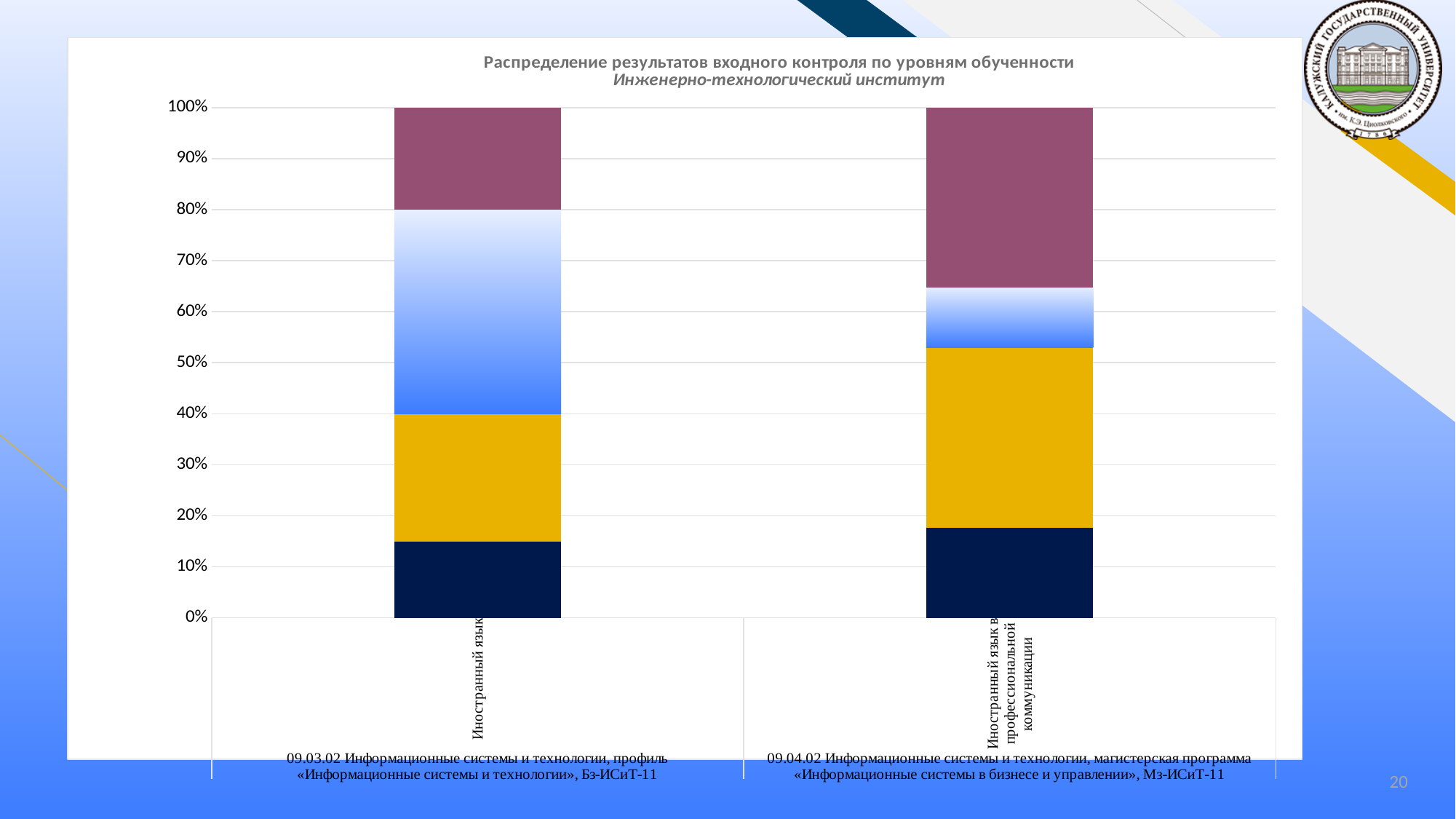
Which bar has the larger yellow segment: 09.03.02 (Бз-ИСиТ-11) or 09.04.02 (Мз-ИСиТ-11)? 09.04.02 (Мз-ИСиТ-11) What is the total height of each stacked bar on the percentage axis? 100% Is the top of the yellow segment in the bar for 09.03.02 (Бз-ИСиТ-11) greater or less than 50%? less Is the bottom of the purple (top) segment in the bar for 09.04.02 (Мз-ИСиТ-11) greater or less than 60%? greater Is the top of the blue segment in the bar for 09.03.02 (Бз-ИСиТ-11) greater or less than 70%? greater What kind of chart is shown on the slide? Stacked bar chart How many bars (categories) are plotted in the chart? 2 Which bar has the larger blue segment: 09.03.02 (Бз-ИСиТ-11) or 09.04.02 (Мз-ИСиТ-11)? 09.03.02 (Бз-ИСиТ-11) What is the first line of the chart title? Распределение результатов входного контроля по уровням обученности Which bar has the larger purple (top) segment: 09.03.02 (Бз-ИСиТ-11) or 09.04.02 (Мз-ИСиТ-11)? 09.04.02 (Мз-ИСиТ-11) Which institute is named in the chart title? Инженерно-технологический институт